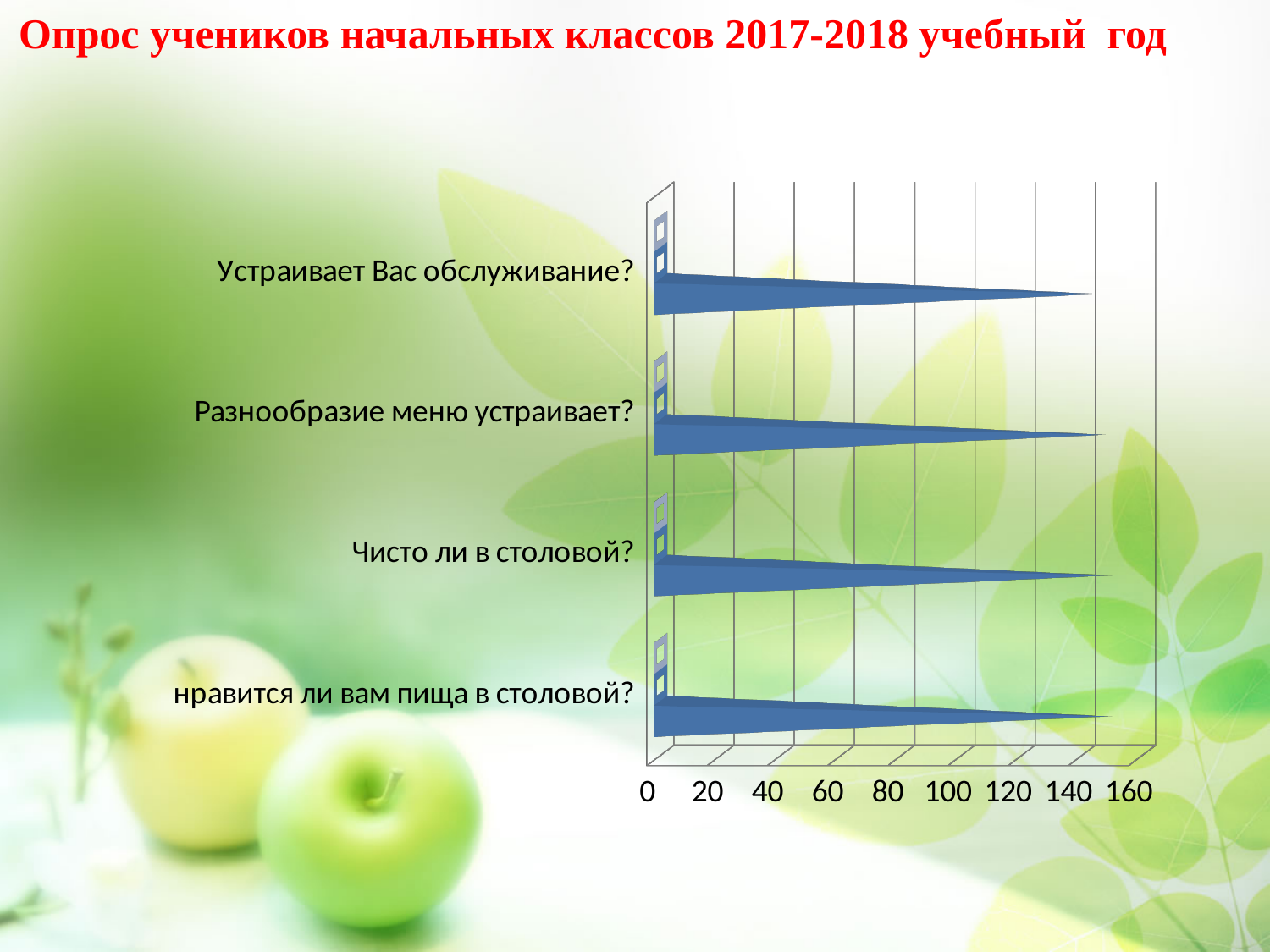
What is the title of the slide containing the chart? Опрос учеников начальных классов 2017-2018 учебный год Is the value for "Разнообразие меню устраивает?" greater or less than 100? greater Is the value for "Устраивает Вас обслуживание?" greater or less than 140? greater Is the value for "Чисто ли в столовой?" greater or less than 160? less How many categories (questions) are plotted on the chart? 4 What kind of chart is shown on the slide? bar chart What is the highest tick value shown on the horizontal axis? 160